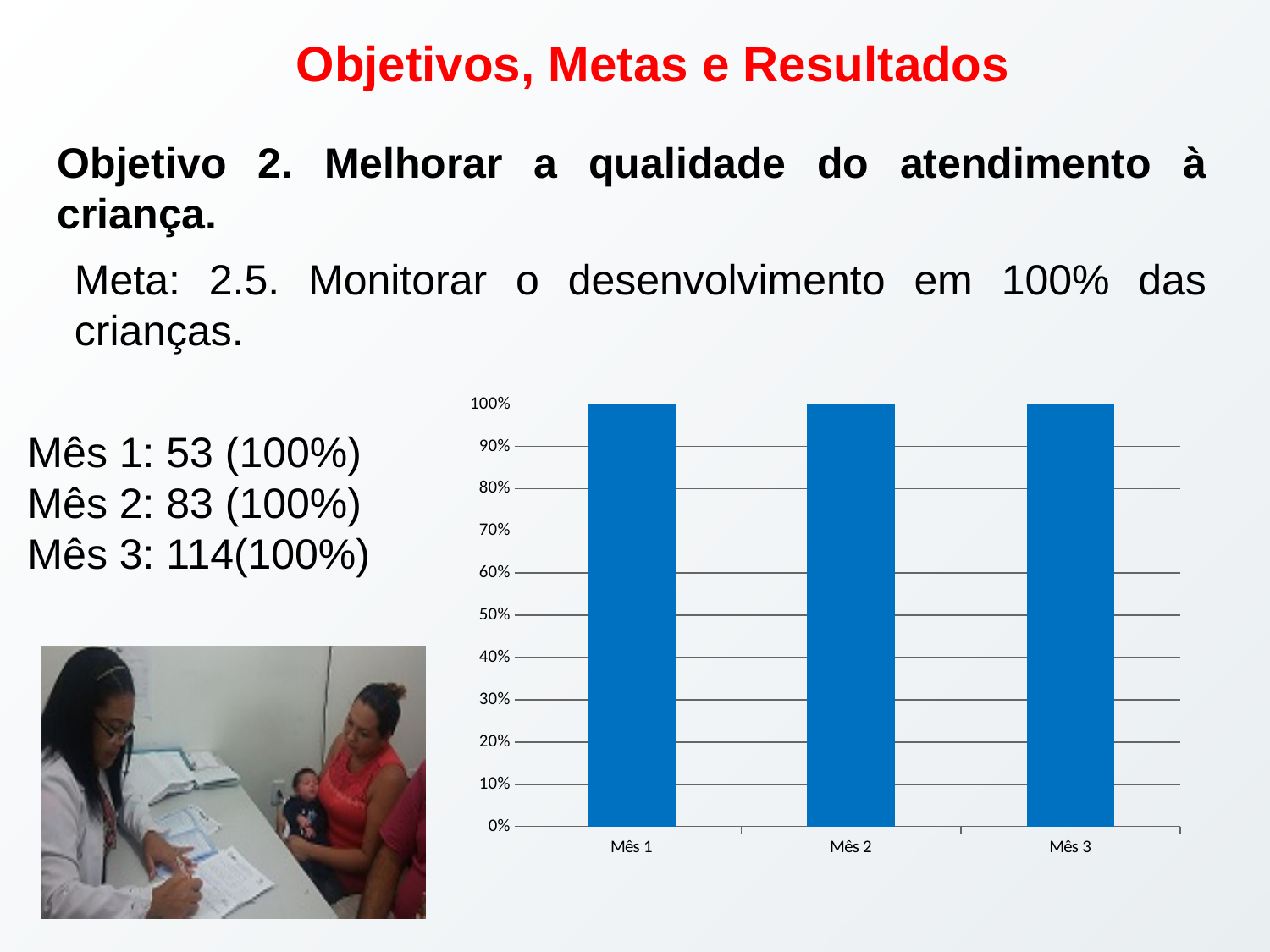
What is the value for Mês 3 in the bar chart? 100% Do the values rise, fall or stay the same from Mês 1 to Mês 3? Stay the same What colour are the bars in the chart? Blue What is the value for Mês 2 in the bar chart? 100% What is the difference between the values for Mês 3 and Mês 1? 0% How many categories are shown on the x axis of the chart? 3 What is the value for Mês 1 in the bar chart? 100% Is the value for Mês 2 greater or less than 50%? greater What is the highest value shown on the y axis of the chart? 100% Is the value for Mês 1 larger than, smaller than, or equal to the value for Mês 3? Equal What kind of chart is shown on the slide? Bar chart